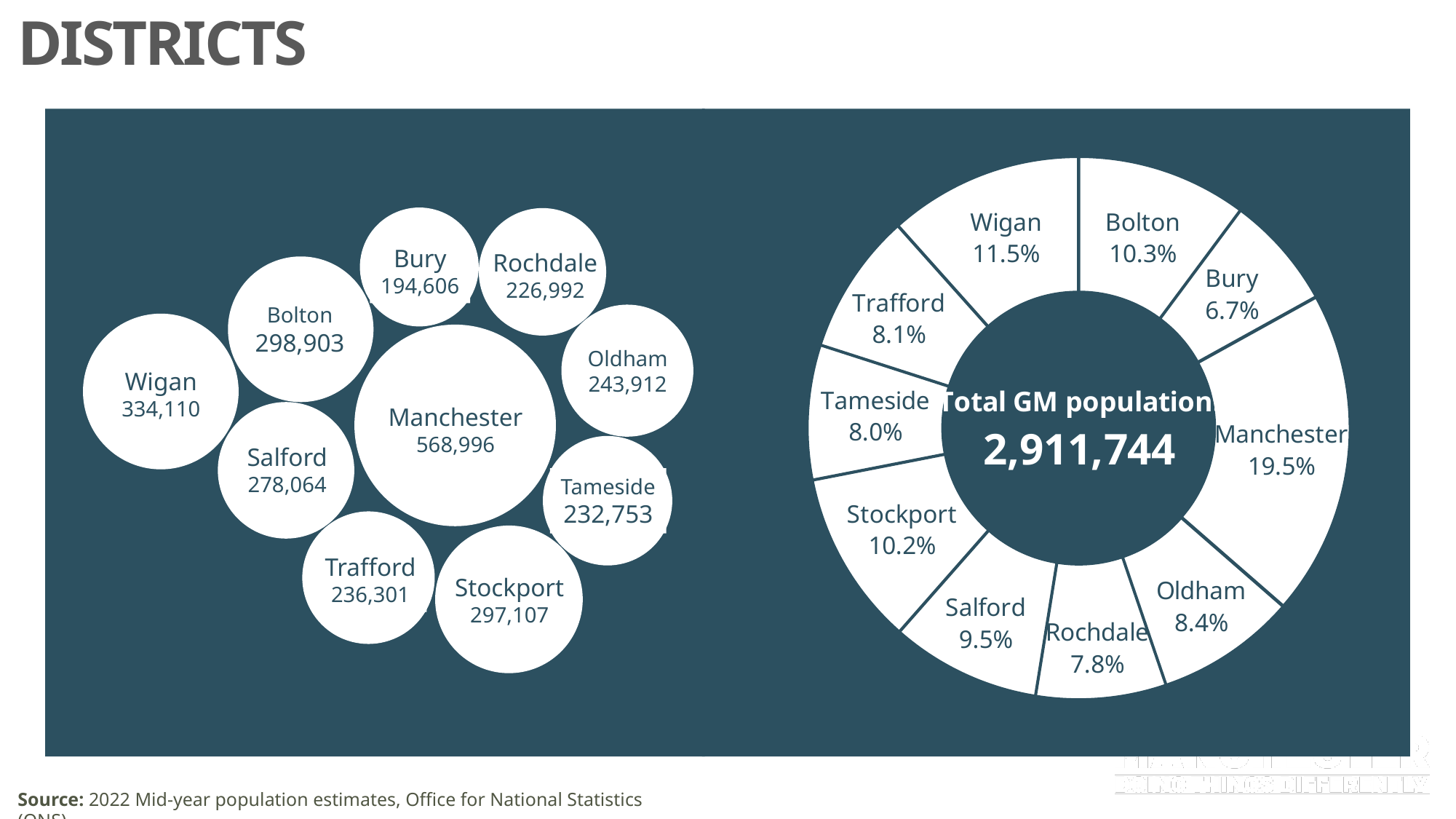
What kind of chart is shown on the right of the slide? Donut (pie) chart How many districts are shown in the bubble chart on the left? 10 In the bubble chart on the left, which district has the smallest population? Bury In the donut chart on the right, what percentage is shown for Rochdale? 7.8% In the bubble chart on the left, what is the population of Manchester? 568,996 What total GM population is shown in the centre of the donut chart on the right? 2,911,744 In the bubble chart on the left, what is the population of Wigan? 334,110 In the bubble chart on the left, which district has the largest population? Manchester In the bubble chart on the left, which has the larger population, Bolton or Stockport? Bolton In the bubble chart on the left, what is the difference between the populations of Manchester and Wigan? 234,886 In the donut chart on the right, what share of the total GM population does Manchester account for? 19.5% In the donut chart on the right, which district has the smallest share? Bury